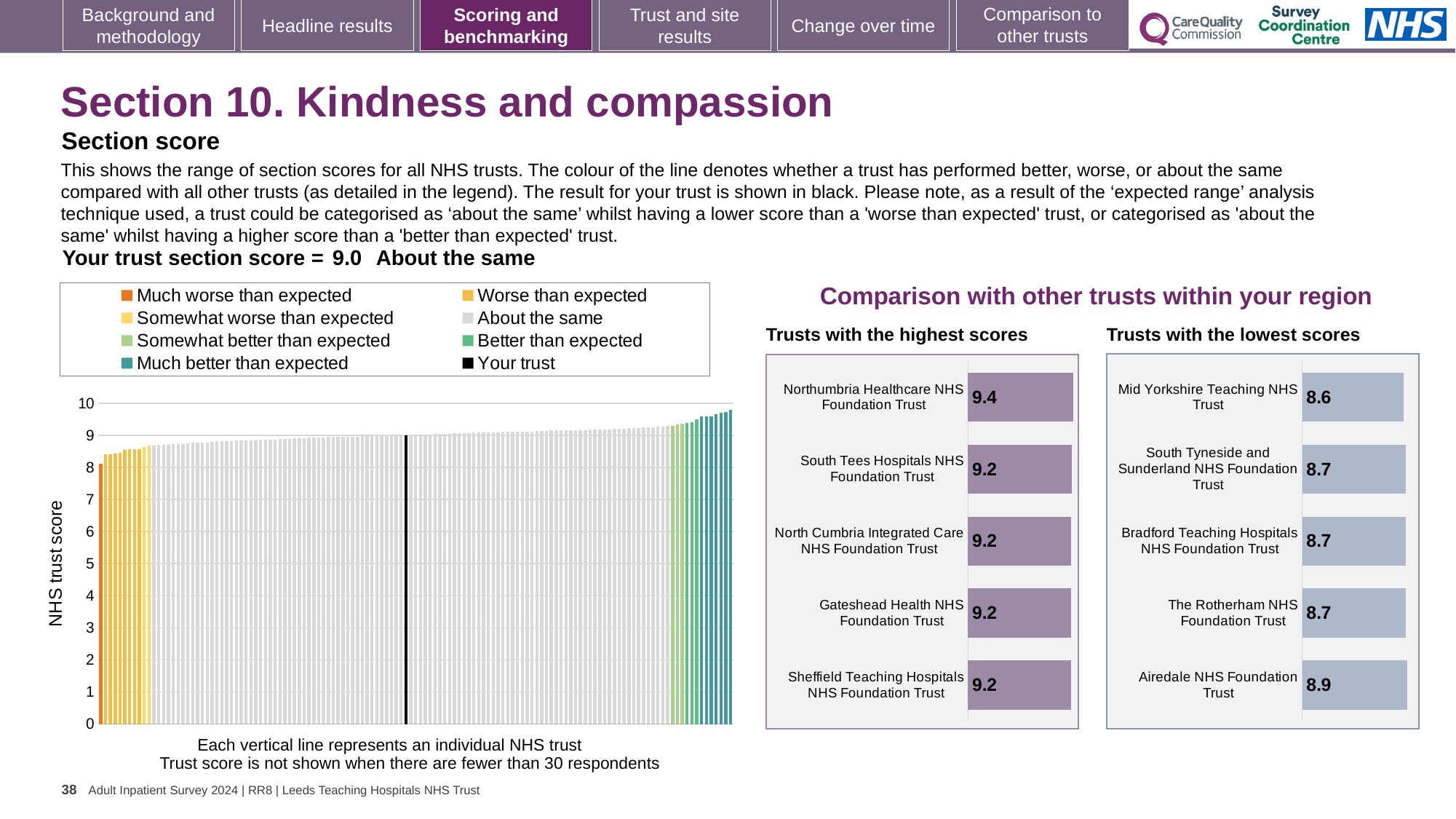
What is the y-axis label of the large bar chart on the left of the slide? NHS trust score In the 'Trusts with the lowest scores' chart, what is the score for Airedale NHS Foundation Trust? 8.9 In the 'Trusts with the lowest scores' chart, which trust has the lowest score? Mid Yorkshire Teaching NHS Trust Which has the larger score: Northumbria Healthcare NHS Foundation Trust in the highest scores chart or Airedale NHS Foundation Trust in the lowest scores chart? Northumbria Healthcare NHS Foundation Trust How many entries does the legend of the large 'NHS trust score' chart list? 8 In the 'Trusts with the highest scores' chart, which trust has the highest score? Northumbria Healthcare NHS Foundation Trust What kind of chart is the large 'NHS trust score' chart on the left of the slide? Bar chart In the 'Trusts with the lowest scores' chart, what is the difference between the scores of Airedale NHS Foundation Trust and Mid Yorkshire Teaching NHS Trust? 0.3 In the large 'NHS trust score' chart on the left, is the value for the highest-scoring trust greater or less than 9? greater In the 'Trusts with the highest scores' chart, what is the difference between the scores of Northumbria Healthcare NHS Foundation Trust and Sheffield Teaching Hospitals NHS Foundation Trust? 0.2 In the 'Trusts with the highest scores' chart, what is the score for Northumbria Healthcare NHS Foundation Trust? 9.4 How many trusts are shown in the 'Trusts with the lowest scores' chart? 5